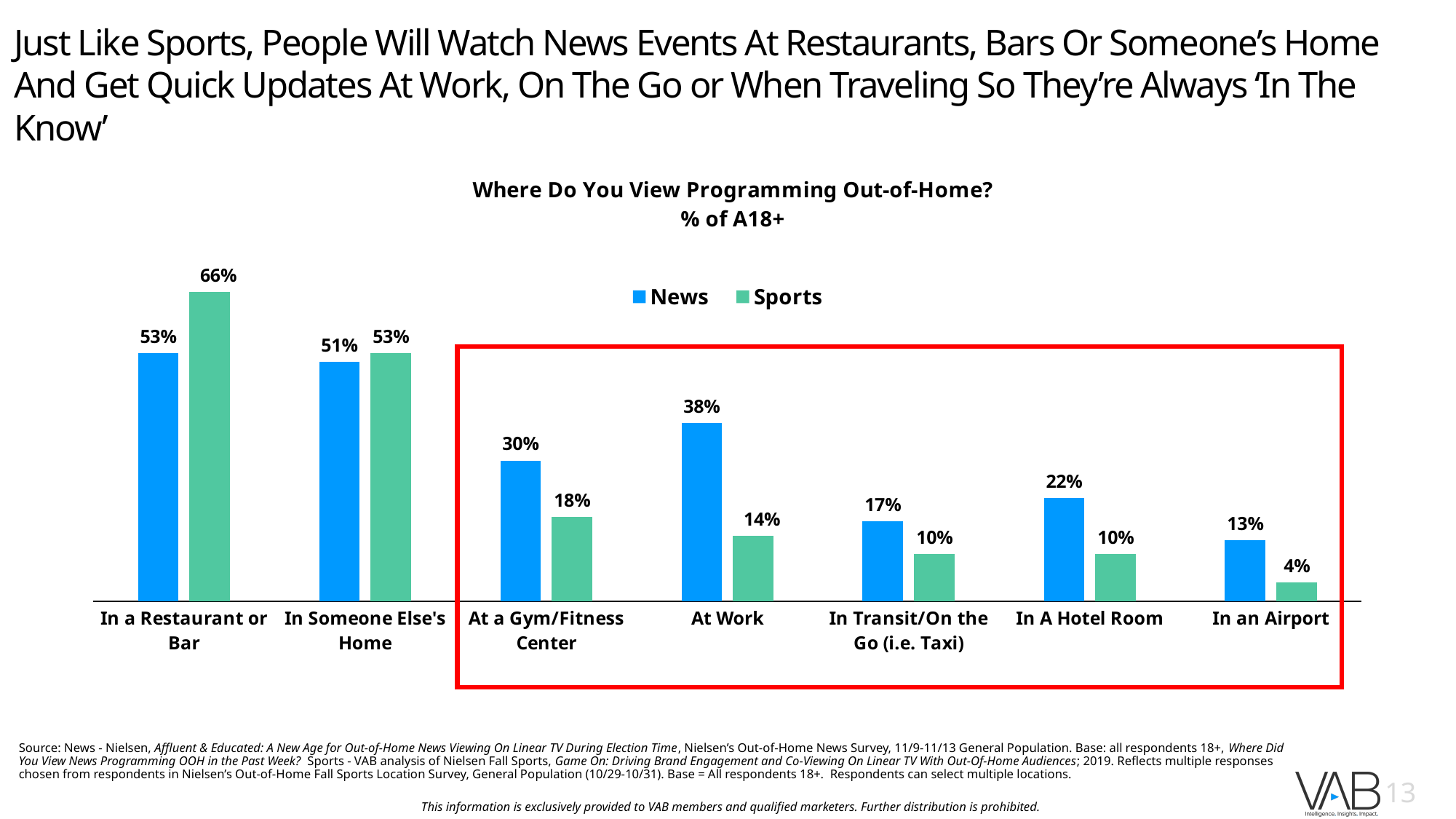
How many locations (categories) are shown on the x axis? 7 What is the difference between the Sports and News values for 'In a Restaurant or Bar'? 13% Which location has the highest value for the News series? In a Restaurant or Bar What percentage of A18+ view Sports programming out-of-home in a restaurant or bar? 66% What is the difference between the News and Sports values for 'At Work'? 24% How many series does the legend list? 2 What percentage of A18+ view News programming out-of-home at work? 38% What type of chart is shown on the slide? Bar chart Which is larger for 'At a Gym/Fitness Center': the News value or the Sports value? News Which location has the lowest value for the Sports series? In an Airport What is the title of the chart? Where Do You View Programming Out-of-Home? % of A18+ What is the Sports value for 'In an Airport'? 4%